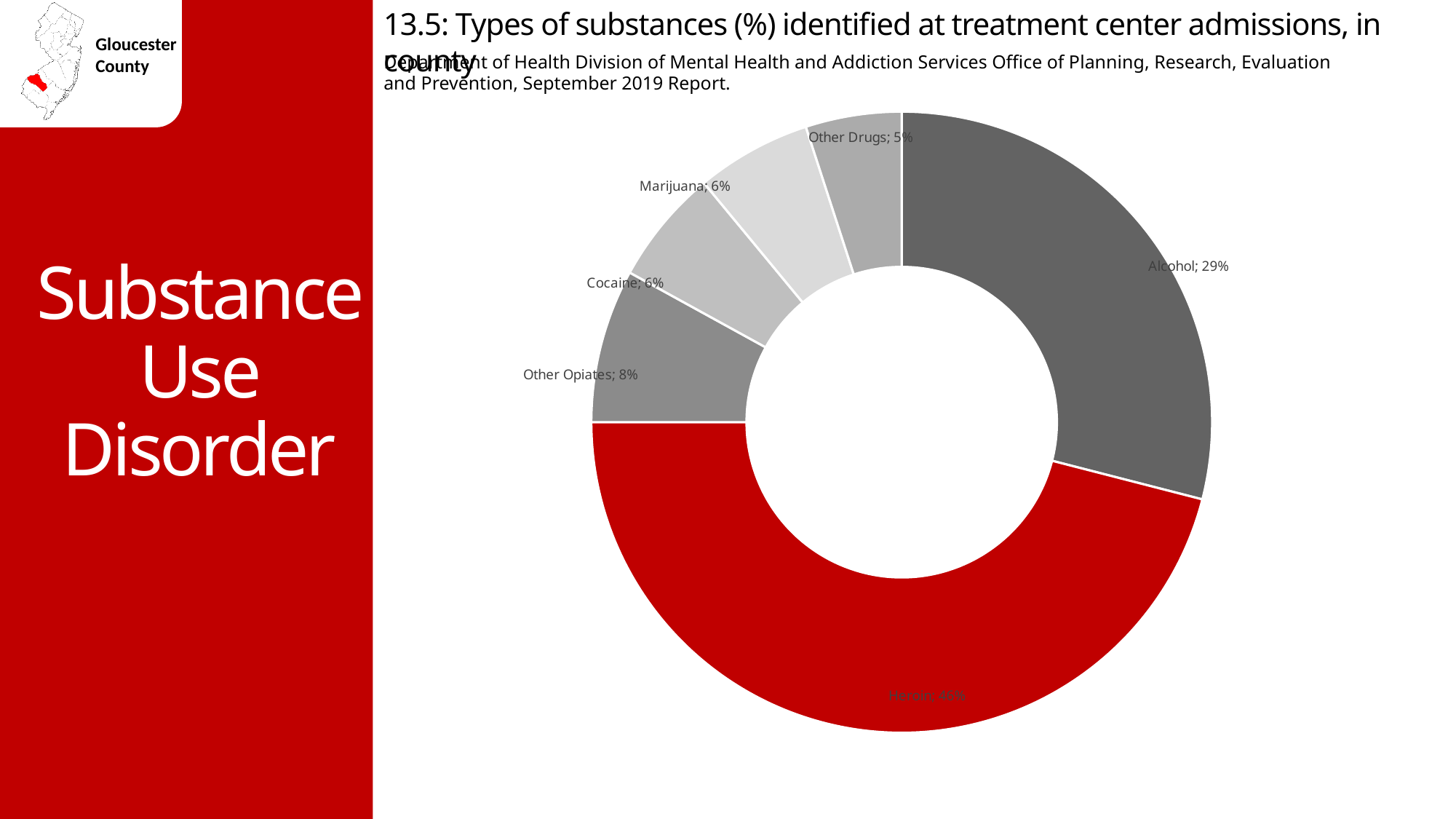
Which substance has the largest share of treatment center admissions? Heroin What percentage is shown for Other Opiates? 8% What percentage is shown for Other Drugs? 5% How many substance categories are shown in the chart? 6 Which slice of the chart is coloured red? Heroin What percentage is shown for Marijuana? 6% What percentage of treatment center admissions identified Alcohol? 29% Which substance has the smallest share of treatment center admissions? Other Drugs Which is larger, the share for Other Opiates or the share for Cocaine? Other Opiates What percentage of treatment center admissions identified Heroin? 46% What is the difference in percentage points between Heroin and Alcohol? 17 What kind of chart is used on this slide? Doughnut (pie) chart